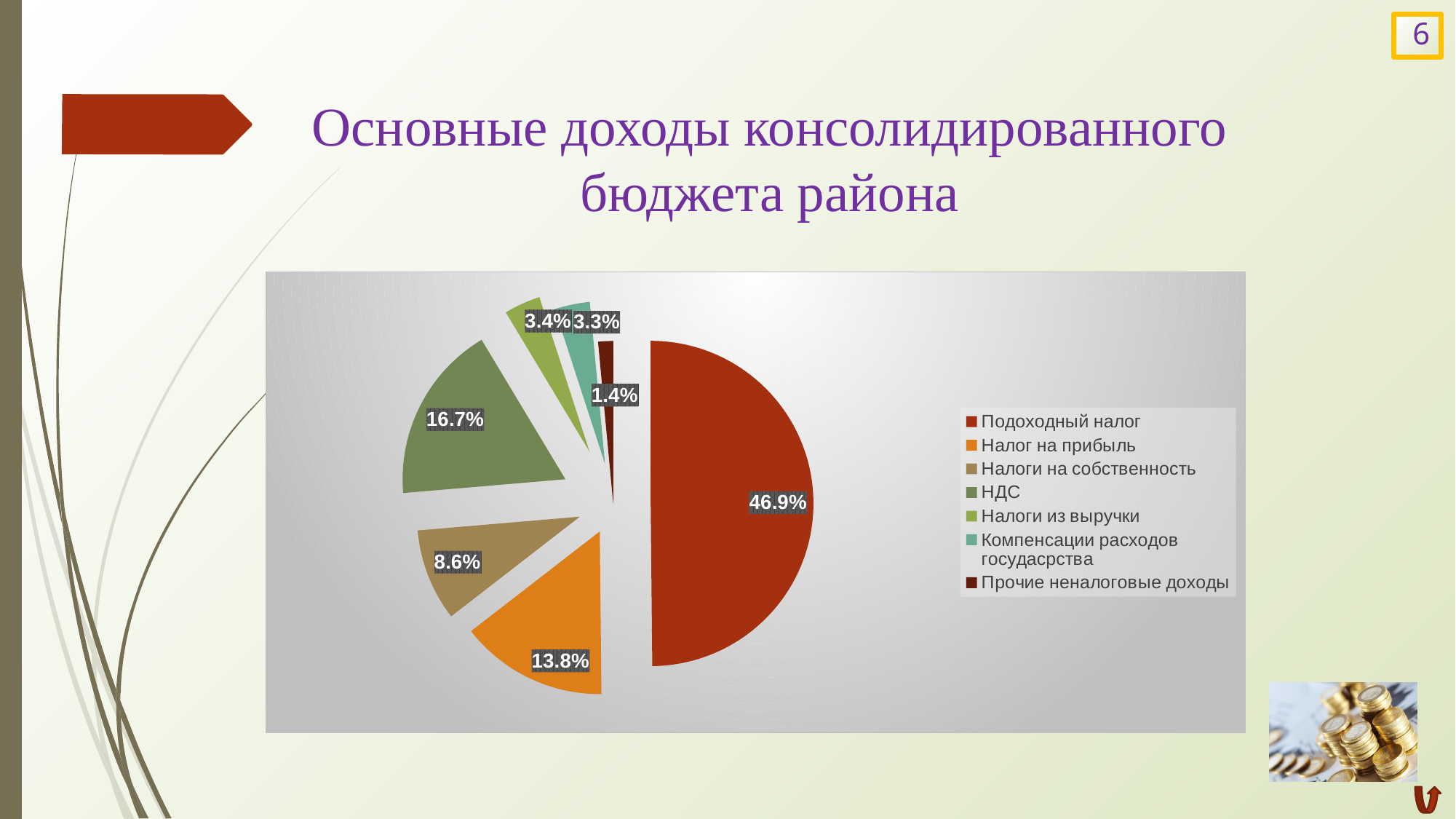
Which category has the smallest slice of the pie? Прочие неналоговые доходы How many categories does the legend list? 7 What is the value shown for Налоги на собственность? 8.6% What is the value shown for Прочие неналоговые доходы? 1.4% What is the difference between the shares of НДС and Налог на прибыль? 2.9% What kind of chart is shown on the slide? pie chart What is the value shown for НДС? 16.7% What is the value shown for Налог на прибыль? 13.8% What share of the pie does Подоходный налог have? 46.9% What is the title of the slide containing the chart? Основные доходы консолидированного бюджета района Which category has the largest slice of the pie? Подоходный налог Which is larger, the share of Налоги на собственность or the share of Налог на прибыль? Налог на прибыль